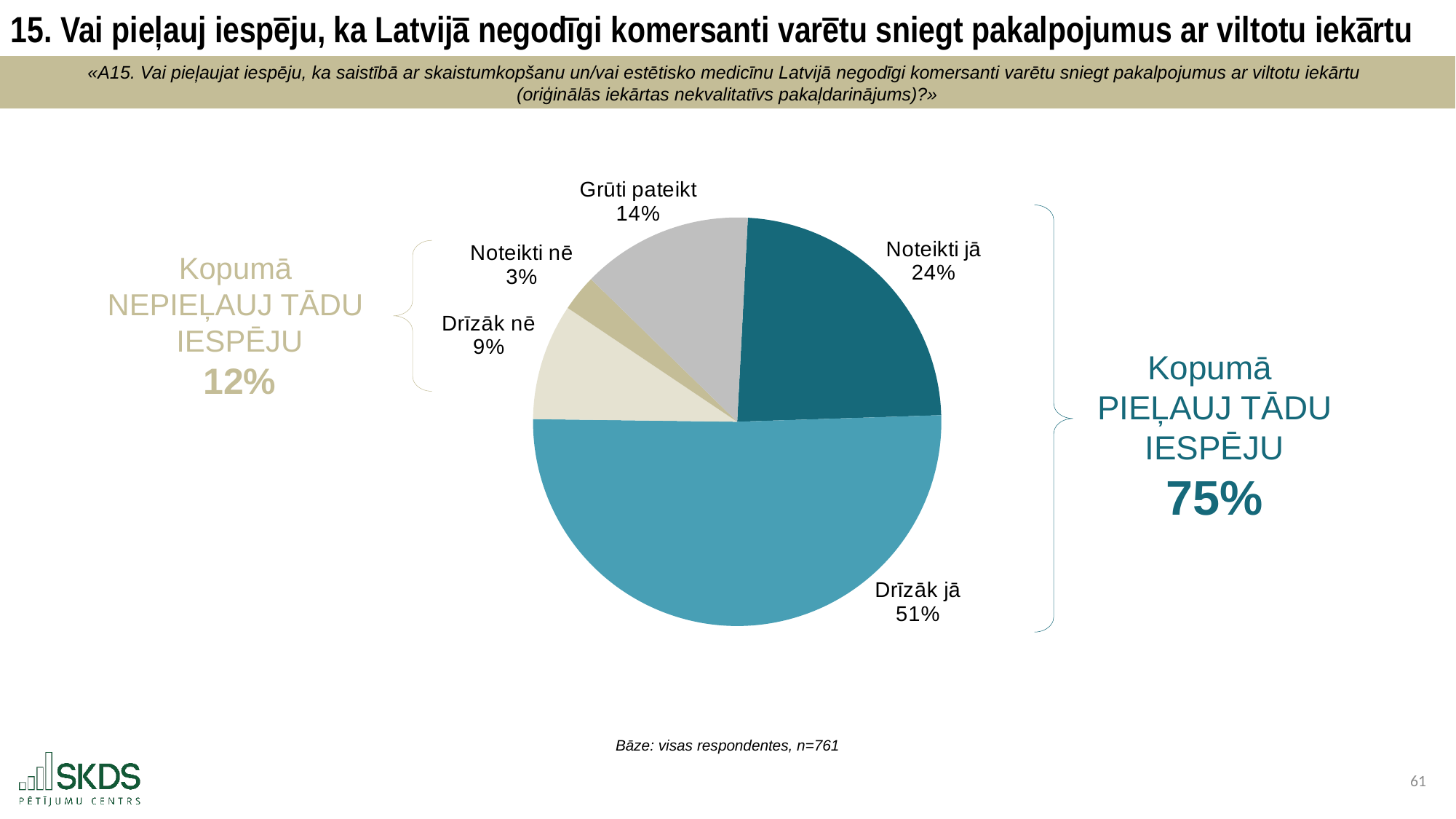
What kind of chart is shown on the slide? pie chart How many slices does the pie chart have? 5 Which is larger, the share for "Grūti pateikt" or the share for "Drīzāk nē"? Grūti pateikt What share of respondents answered "Noteikti nē"? 3% What share of respondents answered "Grūti pateikt"? 14% What share of respondents answered "Noteikti jā"? 24% What combined percentage is shown for "Kopumā PIEĻAUJ TĀDU IESPĒJU"? 75% Which answer category has the smallest slice of the pie? Noteikti nē What share of respondents answered "Drīzāk jā"? 51% What is the difference in percentage points between "Drīzāk jā" and "Noteikti jā"? 27 What share of respondents answered "Drīzāk nē"? 9% Which answer category has the largest slice of the pie? Drīzāk jā